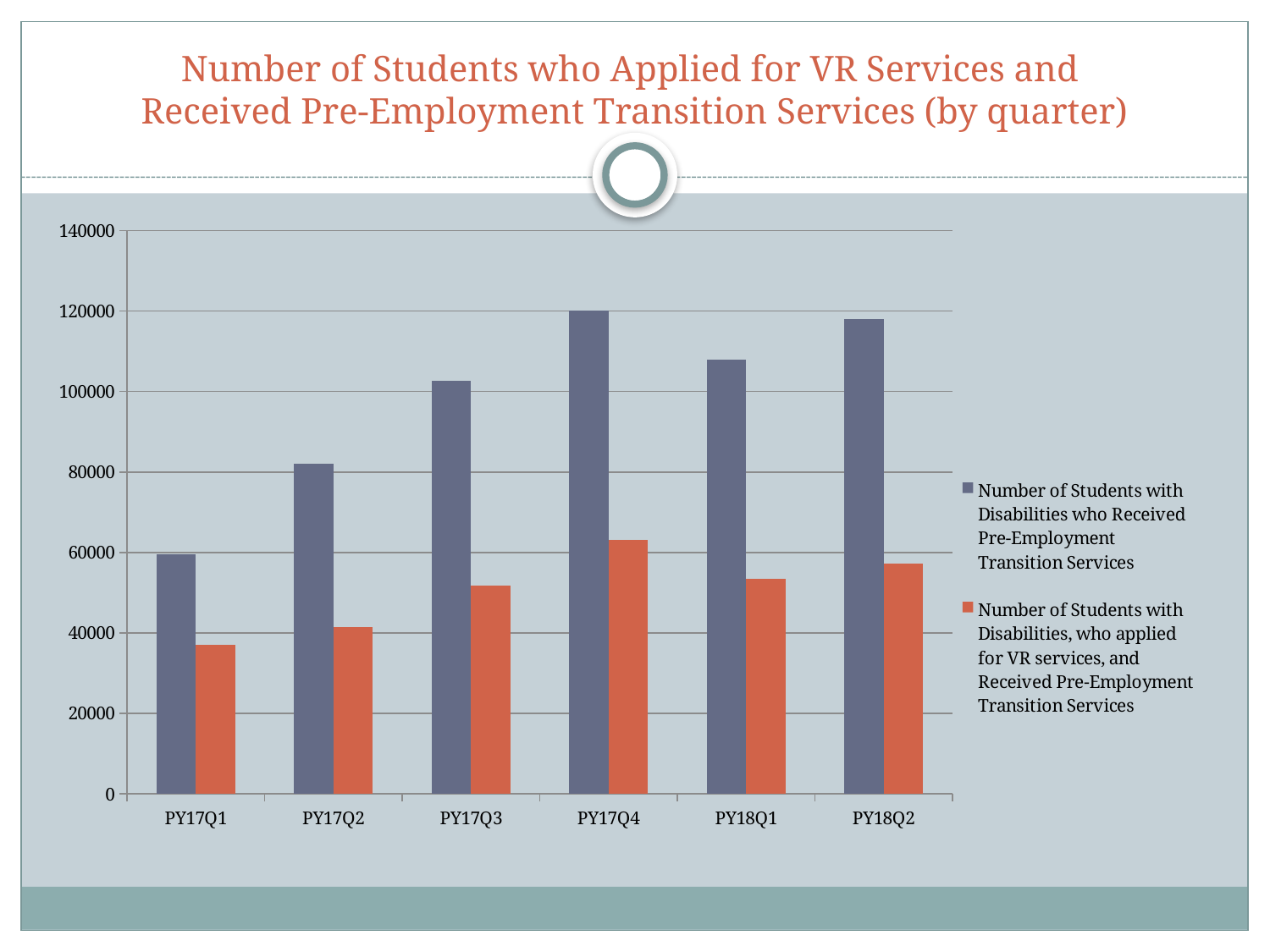
Which quarter has the highest value for Number of Students with Disabilities, who applied for VR services, and Received Pre-Employment Transition Services? PY17Q4 Do the values for Number of Students with Disabilities who Received Pre-Employment Transition Services rise or fall from PY17Q1 to PY17Q4? Rise How many quarters are shown on the x axis? 6 Is the value for Number of Students with Disabilities who Received Pre-Employment Transition Services in PY18Q1 greater or less than 100000? greater How many series does the legend list? 2 Which quarter has the lowest value for Number of Students with Disabilities, who applied for VR services, and Received Pre-Employment Transition Services? PY17Q1 For Number of Students with Disabilities who Received Pre-Employment Transition Services, which is larger: PY17Q4 or PY18Q1? PY17Q4 Is the value for Number of Students with Disabilities, who applied for VR services, and Received Pre-Employment Transition Services in PY17Q1 greater or less than 40000? less What kind of chart is shown on the slide? Bar chart Is the value for Number of Students with Disabilities who Received Pre-Employment Transition Services in PY17Q2 greater or less than 80000? greater Which quarter has the lowest value for Number of Students with Disabilities who Received Pre-Employment Transition Services? PY17Q1